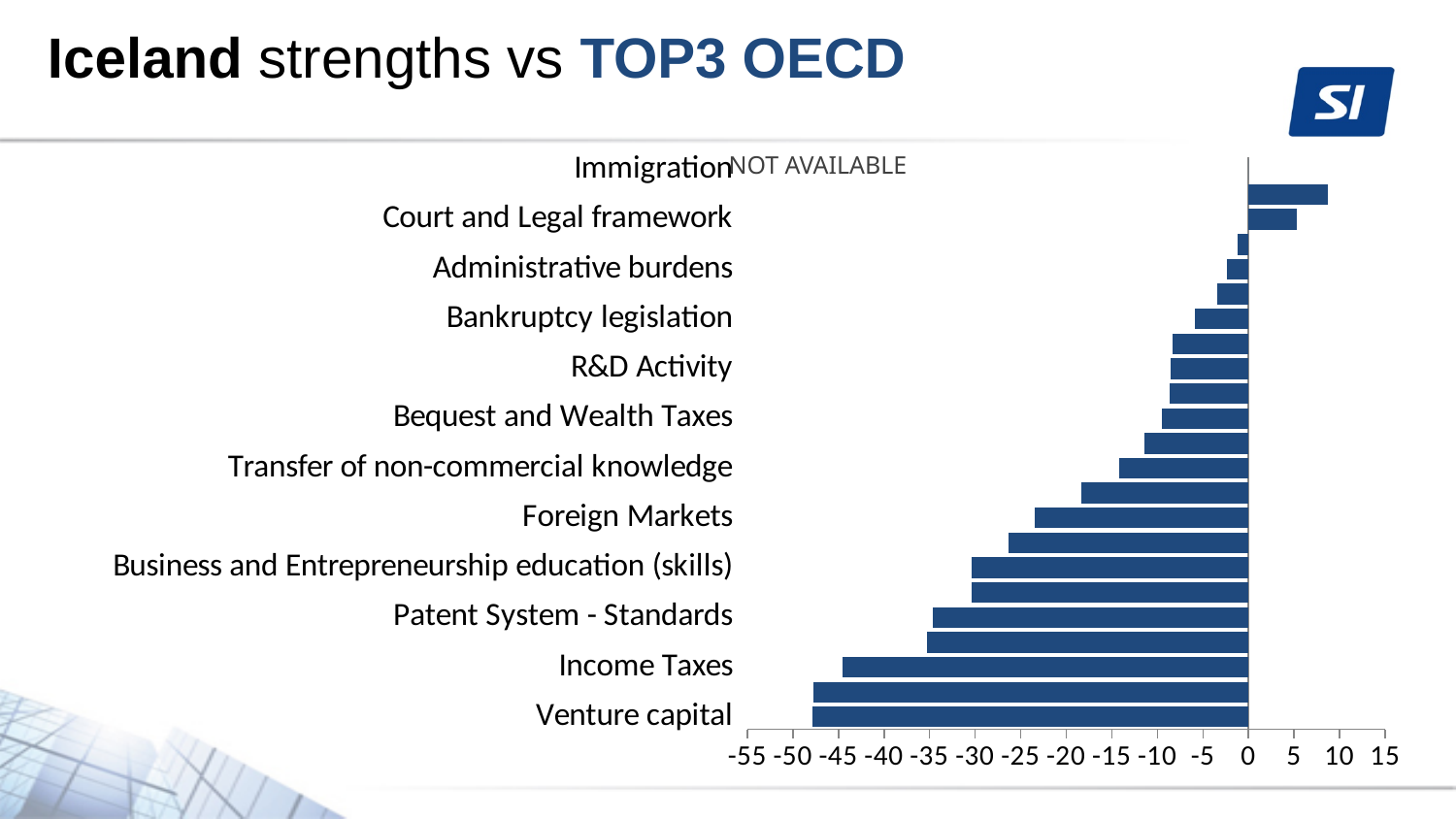
What is shown next to the Immigration category instead of a bar? NOT AVAILABLE Is the value for Transfer of non-commercial knowledge greater or less than -10? less Which has the larger value, Income Taxes or Foreign Markets? Foreign Markets Which has the larger value, Venture capital or Court and Legal framework? Court and Legal framework Is the value for Administrative burdens greater or less than -5? greater Is the value for Court and Legal framework greater or less than 0? greater Do the bar values rise or fall going from the top of the chart to the bottom? fall What kind of chart is shown on the slide? bar chart